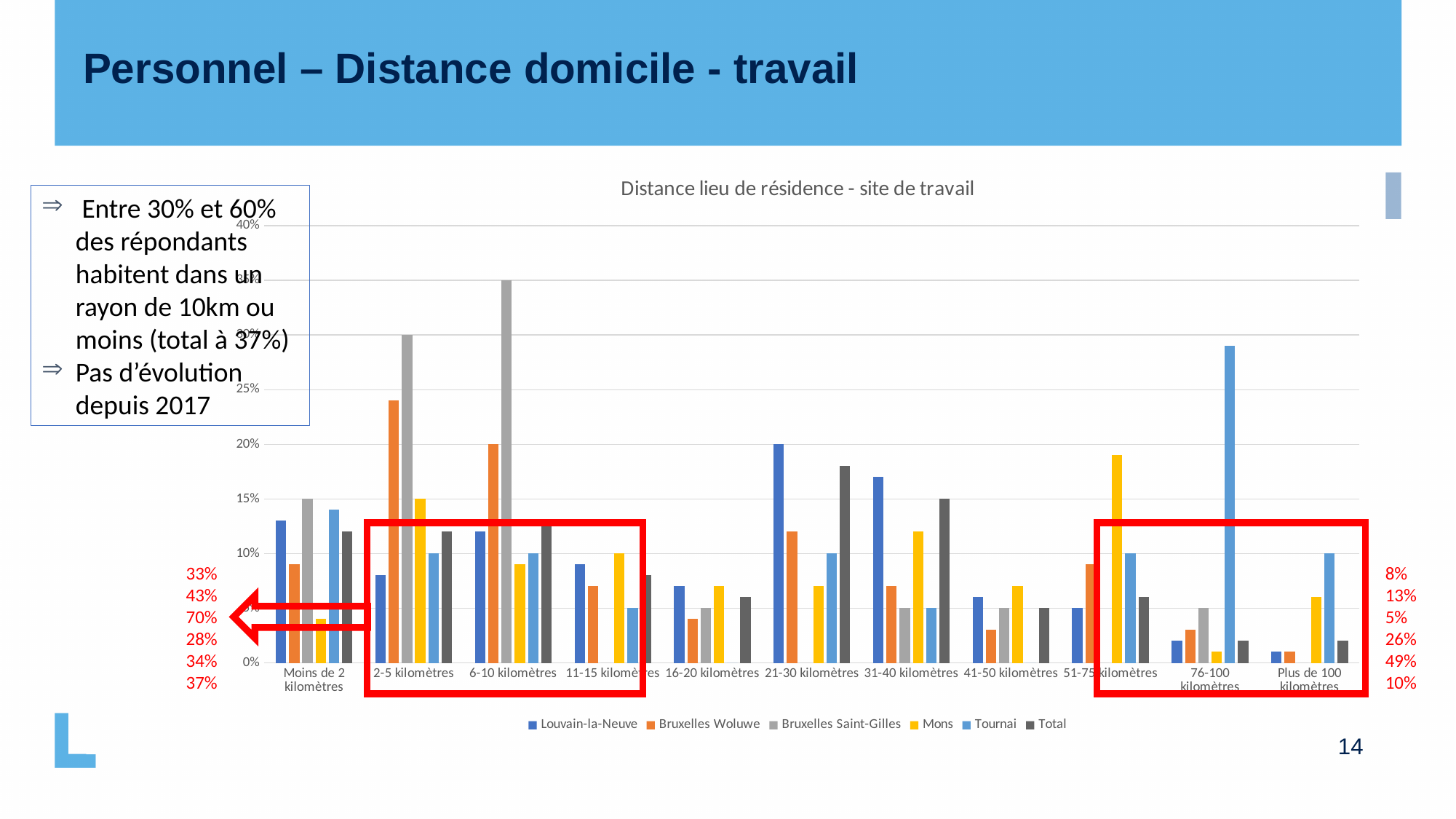
Is the value for Mons in the 51-75 kilomètres category greater or less than 15%? greater Is the value for Louvain-la-Neuve in the 21-30 kilomètres category greater or less than 15%? greater How many series does the legend of the chart list? 6 In the 76-100 kilomètres category, which series has the lowest bar? Mons What is the value for Bruxelles Saint-Gilles in the 6-10 kilomètres category? 35% How many distance categories are shown on the x axis of the chart? 11 In the 6-10 kilomètres category, which series has the highest bar? Bruxelles Saint-Gilles Is the value for Tournai in the 76-100 kilomètres category greater or less than 25%? greater In which distance category does Tournai have its highest bar? 76-100 kilomètres In the 2-5 kilomètres category, which is larger: Bruxelles Woluwe or Louvain-la-Neuve? Bruxelles Woluwe What type of chart is shown on the slide? bar chart What is the title of the chart? Distance lieu de résidence - site de travail